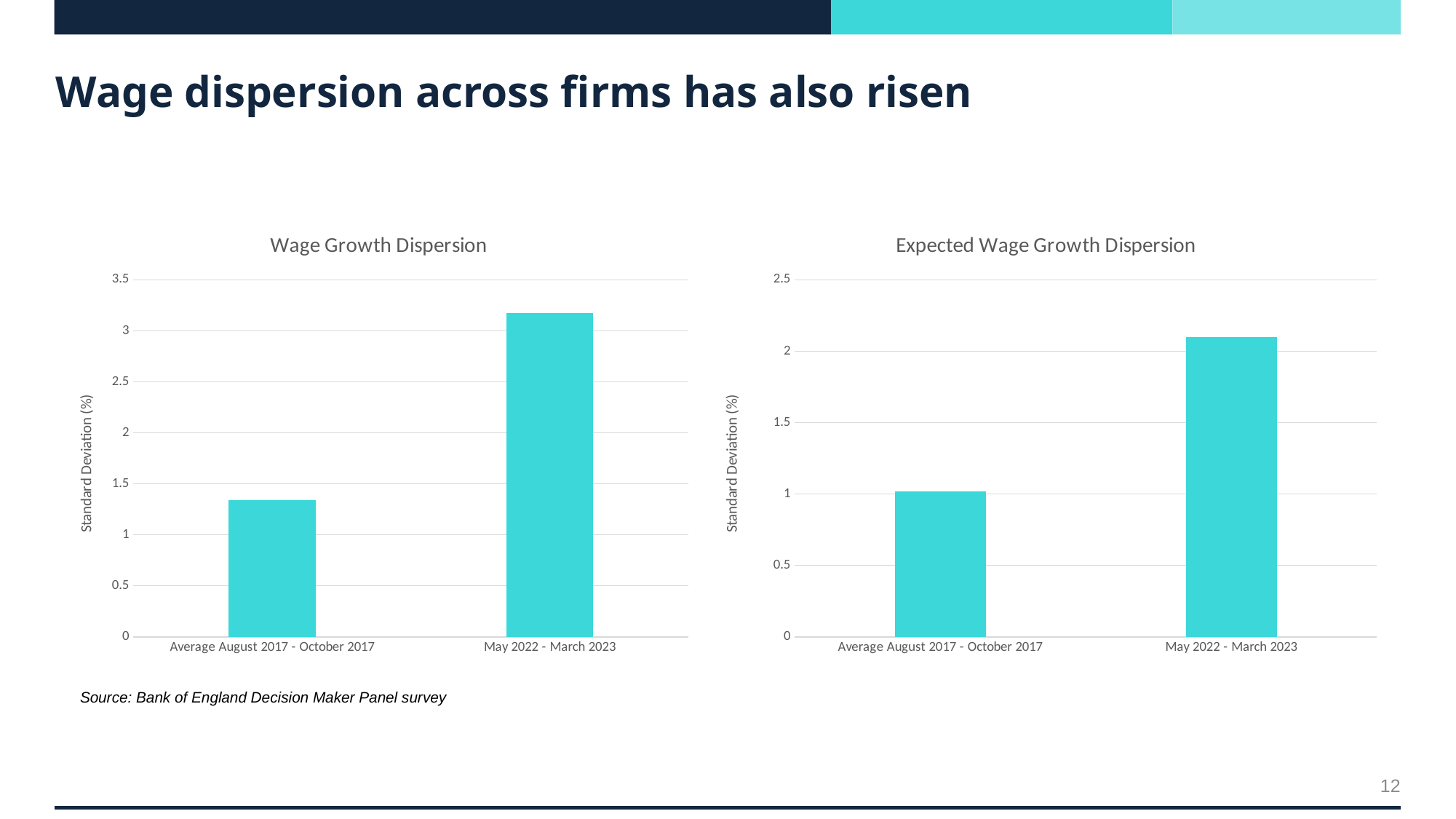
What is the y-axis label of the Expected Wage Growth Dispersion chart? Standard Deviation (%) In the Wage Growth Dispersion chart, is the value for May 2022 - March 2023 greater or less than 3? greater In the Expected Wage Growth Dispersion chart, is the value for Average August 2017 - October 2017 greater or less than 1.5? less In the Expected Wage Growth Dispersion chart, is the value for May 2022 - March 2023 larger or smaller than the value for Average August 2017 - October 2017? larger In the Wage Growth Dispersion chart, is the value for Average August 2017 - October 2017 greater or less than 1.5? less What type of chart is the Expected Wage Growth Dispersion chart? bar chart In the Expected Wage Growth Dispersion chart, which period has the higher standard deviation? May 2022 - March 2023 In the Wage Growth Dispersion chart, which period has the higher standard deviation? May 2022 - March 2023 In the Wage Growth Dispersion chart, which period has the lower standard deviation? Average August 2017 - October 2017 How many bars are shown in the Wage Growth Dispersion chart? 2 In the Wage Growth Dispersion chart, do the values rise or fall from the earlier period to the later period? rise